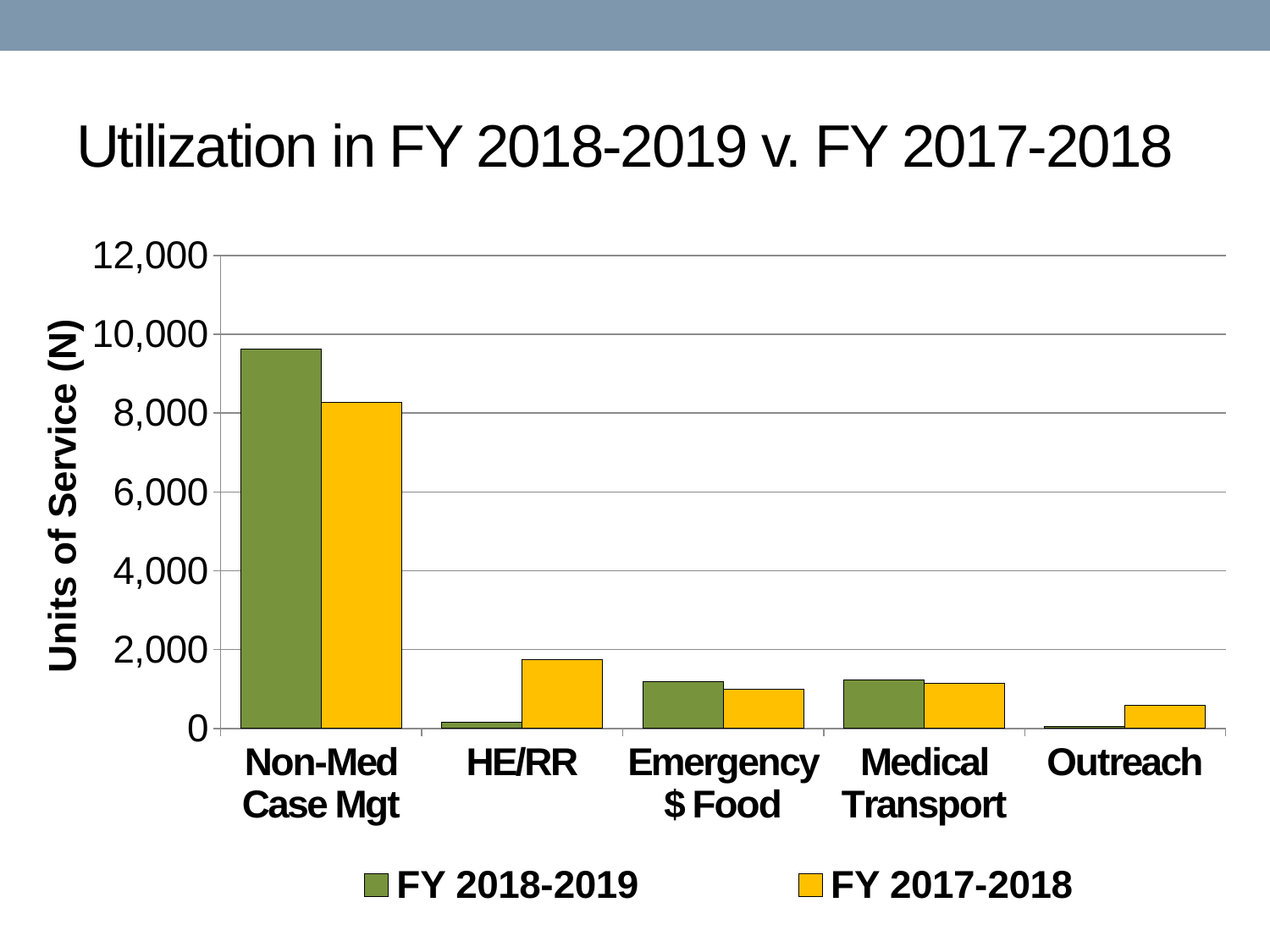
For HE/RR, which series has the larger value, FY 2018-2019 or FY 2017-2018? FY 2017-2018 How many service categories are shown on the x axis? 5 What is the title of the y axis? Units of Service (N) Is the FY 2018-2019 value for Non-Med Case Mgt greater or less than 8,000? greater Is the FY 2017-2018 value for HE/RR greater or less than 2,000? less What kind of chart is shown on the slide? bar chart For Outreach, which series has the larger value, FY 2018-2019 or FY 2017-2018? FY 2017-2018 How many series does the legend list? 2 Which category has the highest value for FY 2018-2019? Non-Med Case Mgt For Non-Med Case Mgt, which series has the larger value, FY 2018-2019 or FY 2017-2018? FY 2018-2019 Which colour represents FY 2017-2018 in the legend? yellow Which category has the lowest value for FY 2017-2018? Outreach